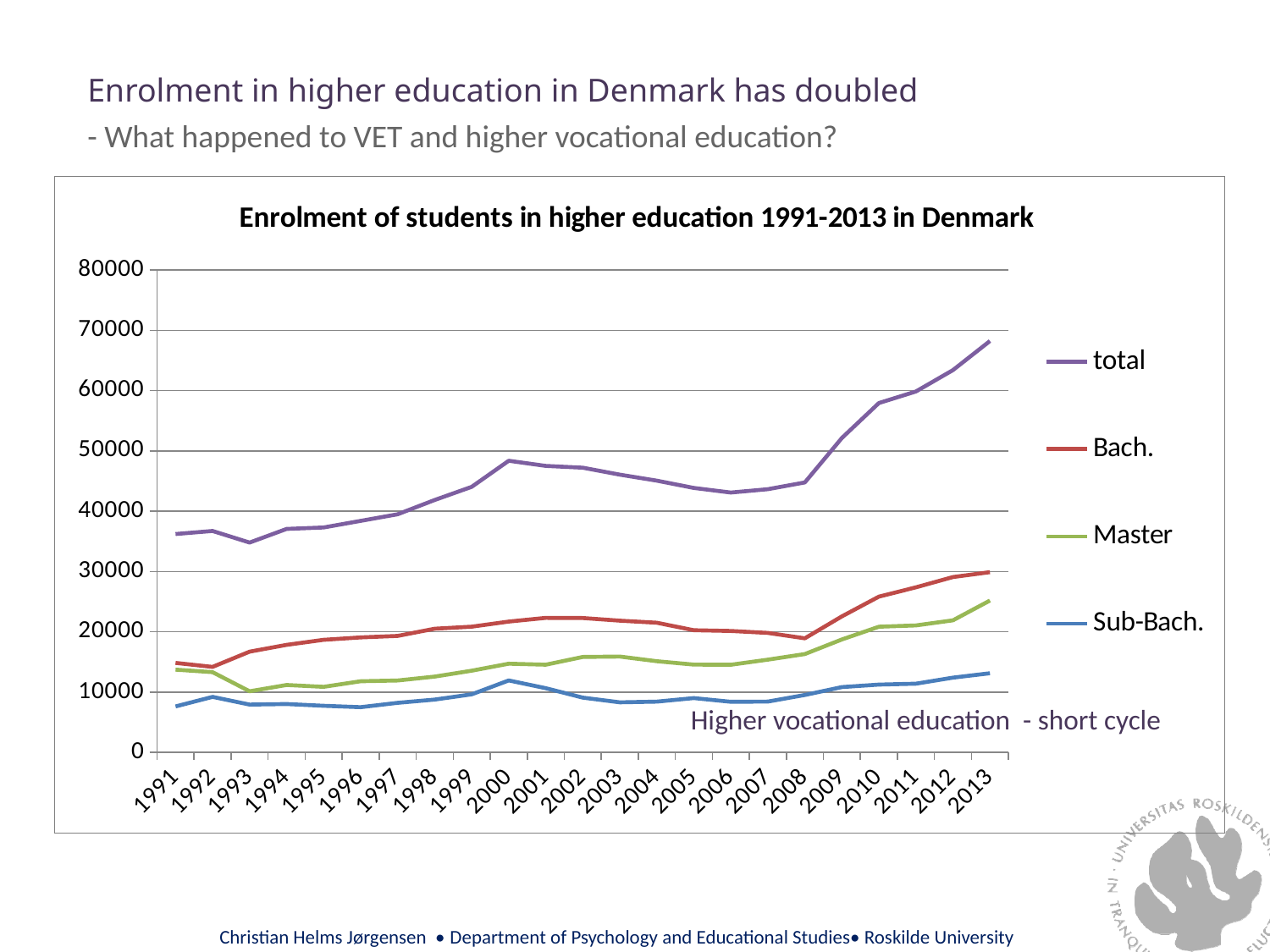
Which series has the highest value in 2013? total Is the value for total in 1991 greater or less than 40000? less Is the value for total in 2013 greater or less than 60000? greater Which series has the lowest value in 2013? Sub-Bach. What is the title of the chart? Enrolment of students in higher education 1991-2013 in Denmark What kind of chart is shown on the slide? line chart How many series does the legend list? 4 Is the value for Sub-Bach. in 2000 greater or less than 20000? less How many years are plotted along the x axis? 23 Does the total series rise or fall from 2008 to 2013? rise Which is larger in 2013, Bach. or Master? Bach.